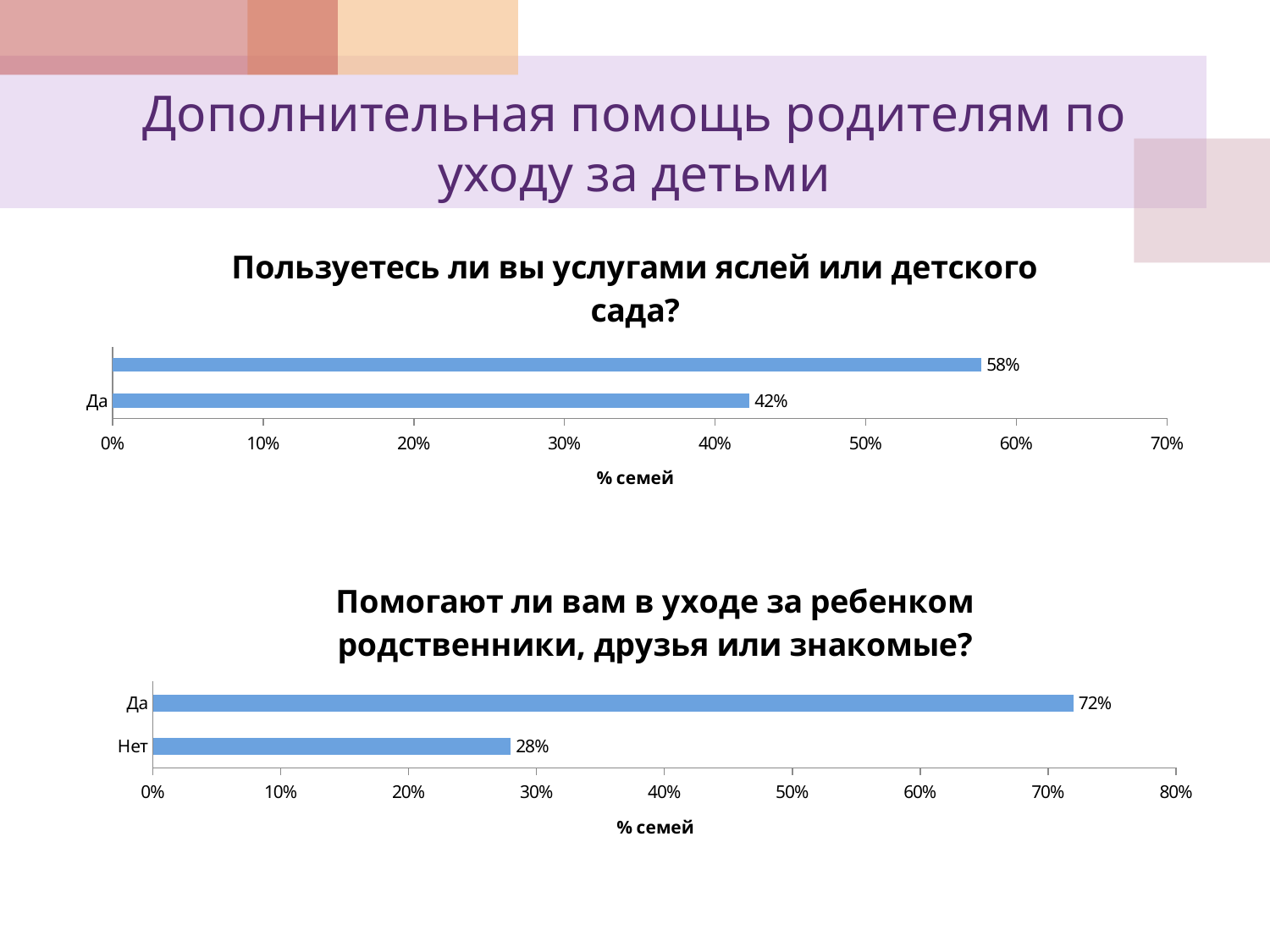
In the top chart 'Пользуетесь ли вы услугами яслей или детского сада?', what value is printed on the longest bar? 58% In the top chart 'Пользуетесь ли вы услугами яслей или детского сада?', how many bars are plotted? 2 What is the x-axis title of the bottom chart 'Помогают ли вам в уходе за ребенком родственники, друзья или знакомые?'? % семей In the bottom chart 'Помогают ли вам в уходе за ребенком родственники, друзья или знакомые?', which category has the lowest value? Нет What type of chart is the bottom chart 'Помогают ли вам в уходе за ребенком родственники, друзья или знакомые?'? Bar chart In the bottom chart 'Помогают ли вам в уходе за ребенком родственники, друзья или знакомые?', what is the value for 'Нет'? 28% In the bottom chart 'Помогают ли вам в уходе за ребенком родственники, друзья или знакомые?', which category has the highest value? Да In the top chart 'Пользуетесь ли вы услугами яслей или детского сада?', is the value for 'Да' greater or less than 50%? less In the top chart 'Пользуетесь ли вы услугами яслей или детского сада?', what is the value for 'Да'? 42% In the top chart 'Пользуетесь ли вы услугами яслей или детского сада?', what is the difference between the two bar values? 16 percentage points In the bottom chart 'Помогают ли вам в уходе за ребенком родственники, друзья или знакомые?', what is the difference between 'Да' and 'Нет'? 44 percentage points In the bottom chart 'Помогают ли вам в уходе за ребенком родственники, друзья или знакомые?', what is the value for 'Да'? 72%